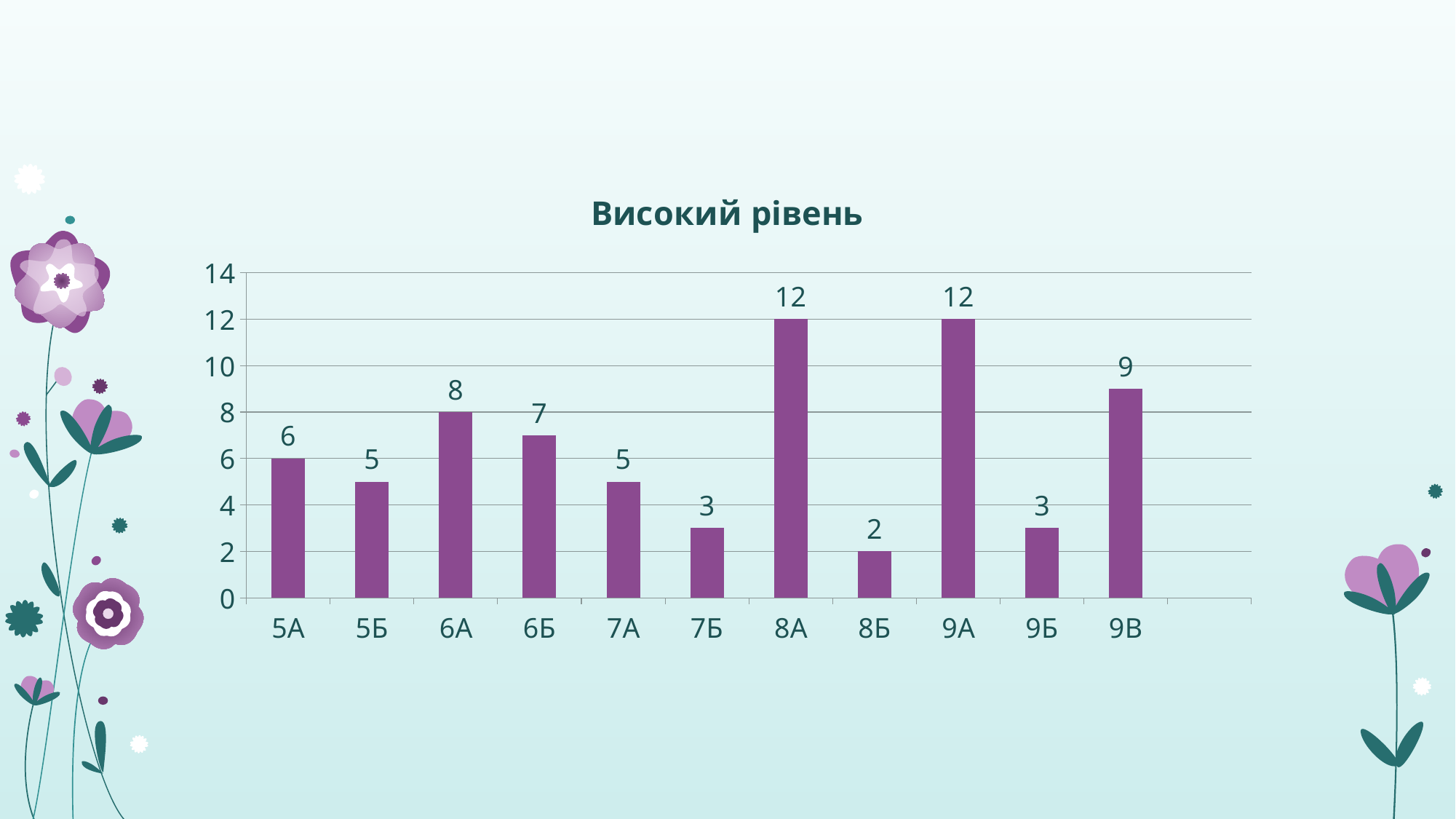
What is the value for 9В in the chart? 9 Which two categories share the highest value in the chart? 8А and 9А Which is larger, the value for 5А or the value for 5Б? 5А What is the difference between the values for 8А and 8Б? 10 What is the value for 6А in the chart? 8 What is the title of the chart? Високий рівень Which category has the lowest value in the chart? 8Б How many categories are shown on the x axis of the chart? 11 What kind of chart is shown on the slide? Bar chart What is the value for 8Б in the chart? 2 What is the difference between the values for 9В and 6Б? 2 Which is larger, the value for 7Б or the value for 9Б? They are equal (3)